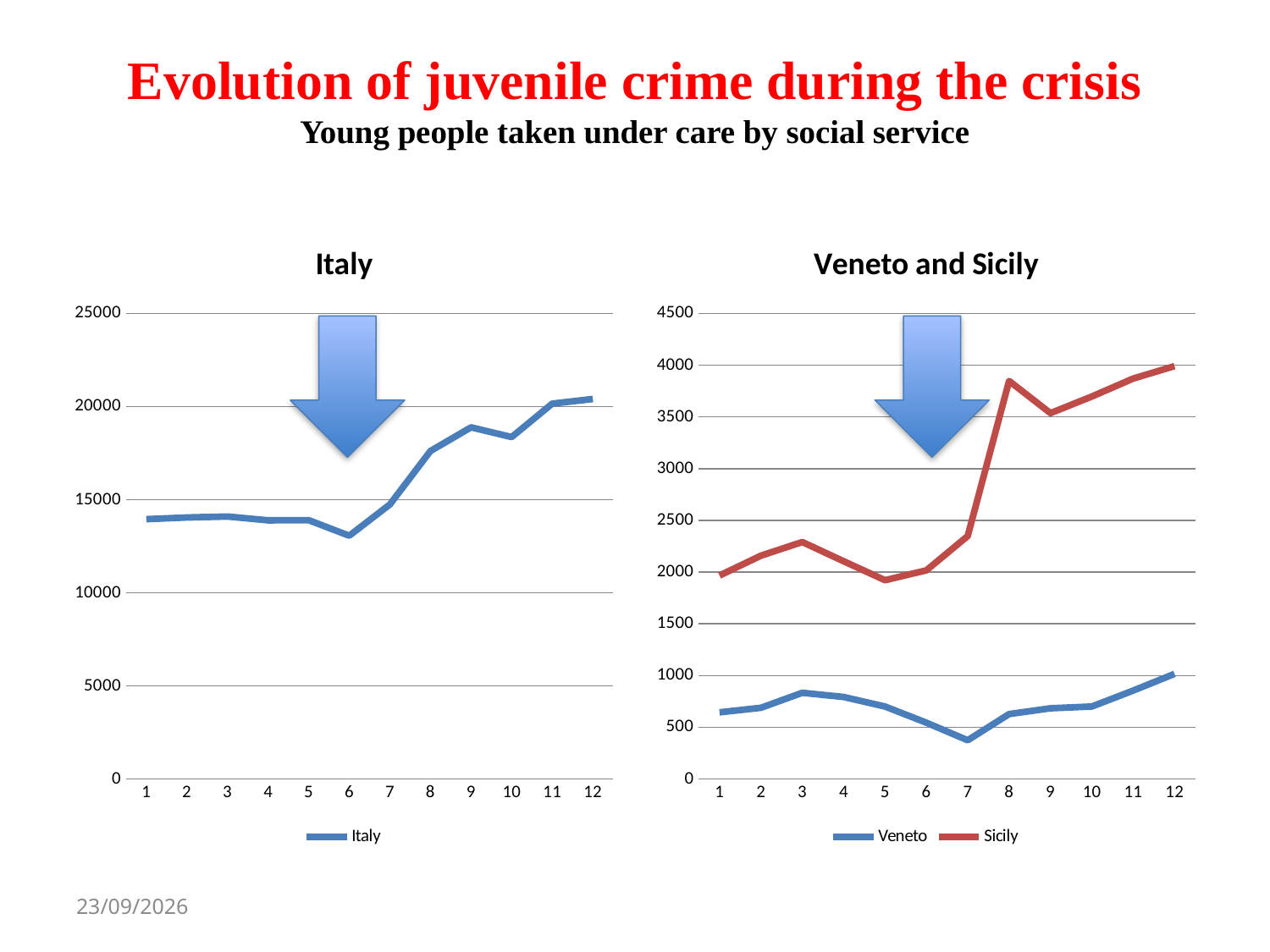
In the 'Veneto and Sicily' chart, at which x-axis point is the Veneto value lowest? 7 How many series does the legend of the 'Veneto and Sicily' chart list? 2 In the 'Veneto and Sicily' chart, at which x-axis point is the Sicily value highest? 12 In the 'Italy' chart, is the value at point 12 greater or less than 20000? greater In the 'Italy' chart, at which x-axis point is the value lowest? 6 In the 'Veneto and Sicily' chart, is the Sicily value at point 8 greater or less than 3500? greater In the 'Veneto and Sicily' chart, which series has the larger value at point 12, Veneto or Sicily? Sicily In the 'Veneto and Sicily' chart, is the Veneto value at point 7 greater or less than 500? less What kind of chart is the 'Italy' chart? line chart In the 'Veneto and Sicily' chart, what colour is the Sicily line? red How many points are plotted along the x axis of the 'Italy' chart? 12